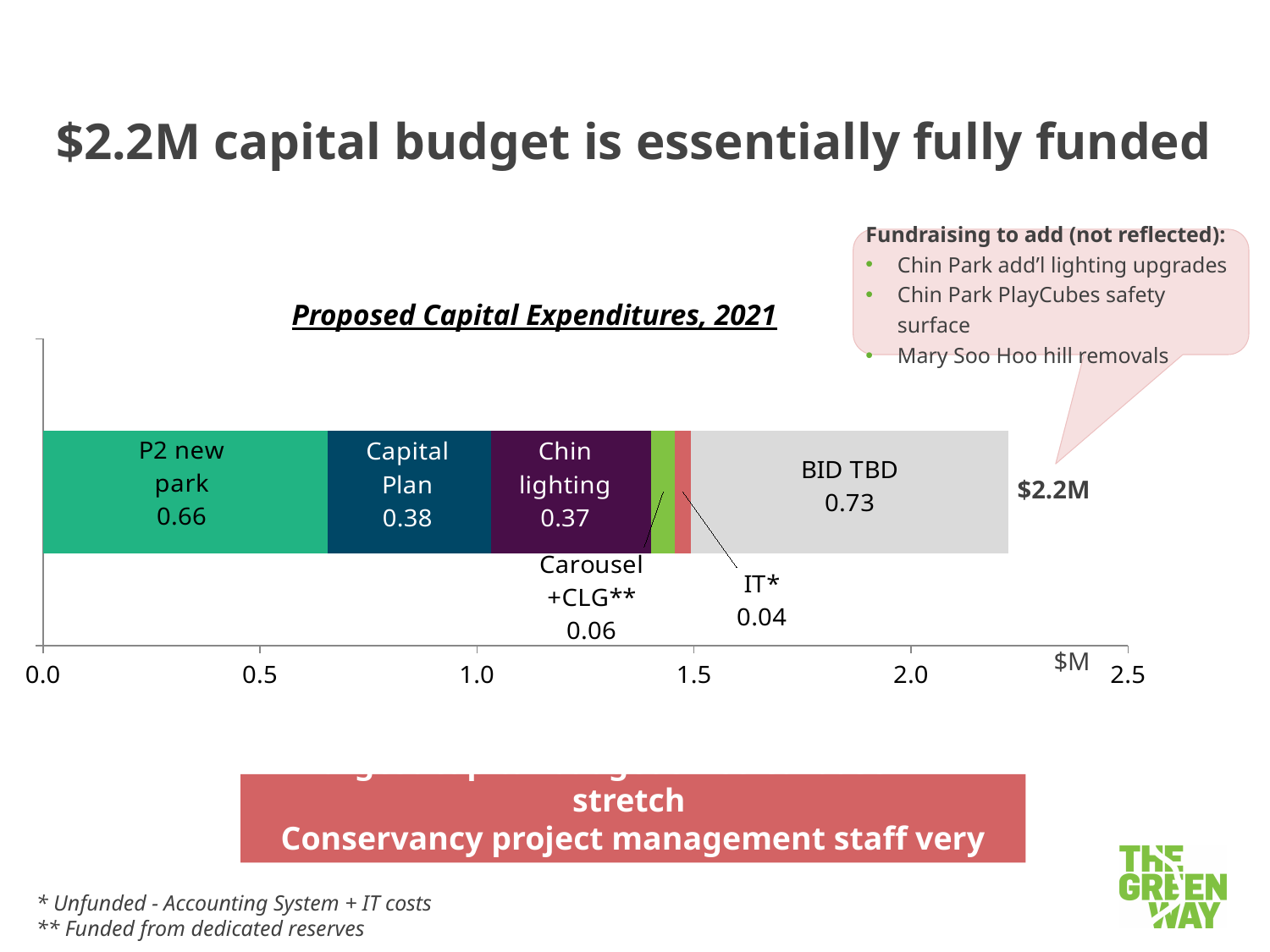
How many segments make up the stacked bar in the chart? 6 What is the value for Carousel +CLG** in the chart? 0.06 Which segment of the stacked bar has the largest value? BID TBD What is the value for BID TBD in the Proposed Capital Expenditures, 2021 chart? 0.73 What total is labelled at the end of the stacked bar? $2.2M What is the title of the chart on the slide? Proposed Capital Expenditures, 2021 What kind of chart is shown on the slide? Stacked bar chart What is the difference between the P2 new park value and the Capital Plan value? 0.28 Which segment of the stacked bar has the smallest value? IT* Which is larger, the value for Capital Plan or the value for Chin lighting? Capital Plan What is the value for IT* in the chart? 0.04 What is the value for P2 new park in the Proposed Capital Expenditures, 2021 chart? 0.66